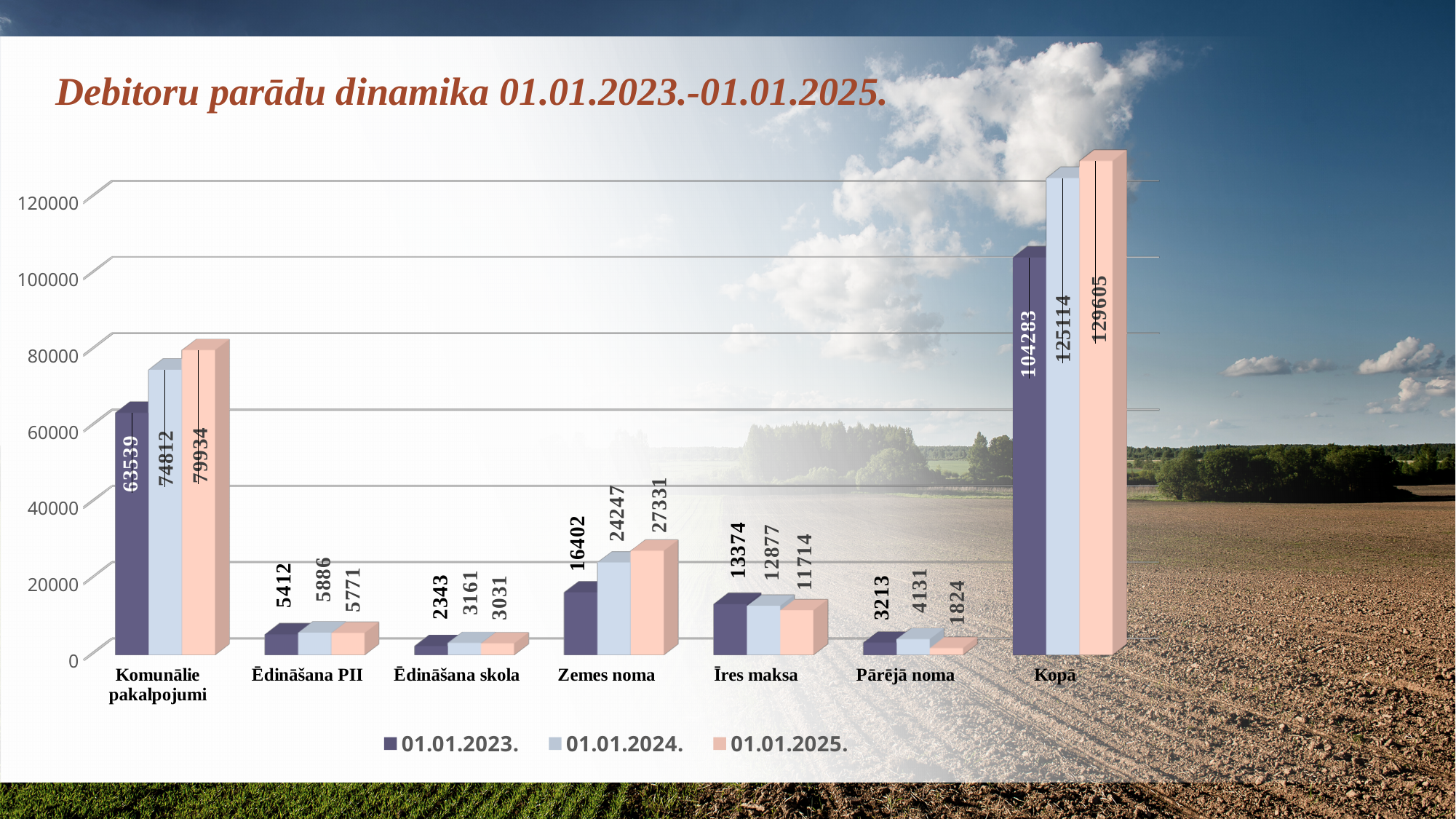
Excluding Kopā, which category has the highest value in the 01.01.2024. series? Komunālie pakalpojumi What is the value for Komunālie pakalpojumi in the 01.01.2025. series? 79934 Which is larger for Īres maksa: the 01.01.2023. value or the 01.01.2025. value? 01.01.2023. What is the value for Pārējā noma in the 01.01.2024. series? 4131 What is the value for Zemes noma in the 01.01.2023. series? 16402 What kind of chart is shown on the slide? bar chart How many categories are shown on the x axis? 7 How many series does the legend list? 3 What is the Kopā value for 01.01.2025.? 129605 Do the values for Īres maksa rise or fall from 01.01.2023. to 01.01.2025.? fall Excluding Kopā, which category has the lowest value in the 01.01.2023. series? Ēdināšana skola What is the difference between the Kopā values for 01.01.2025. and 01.01.2023.? 25322